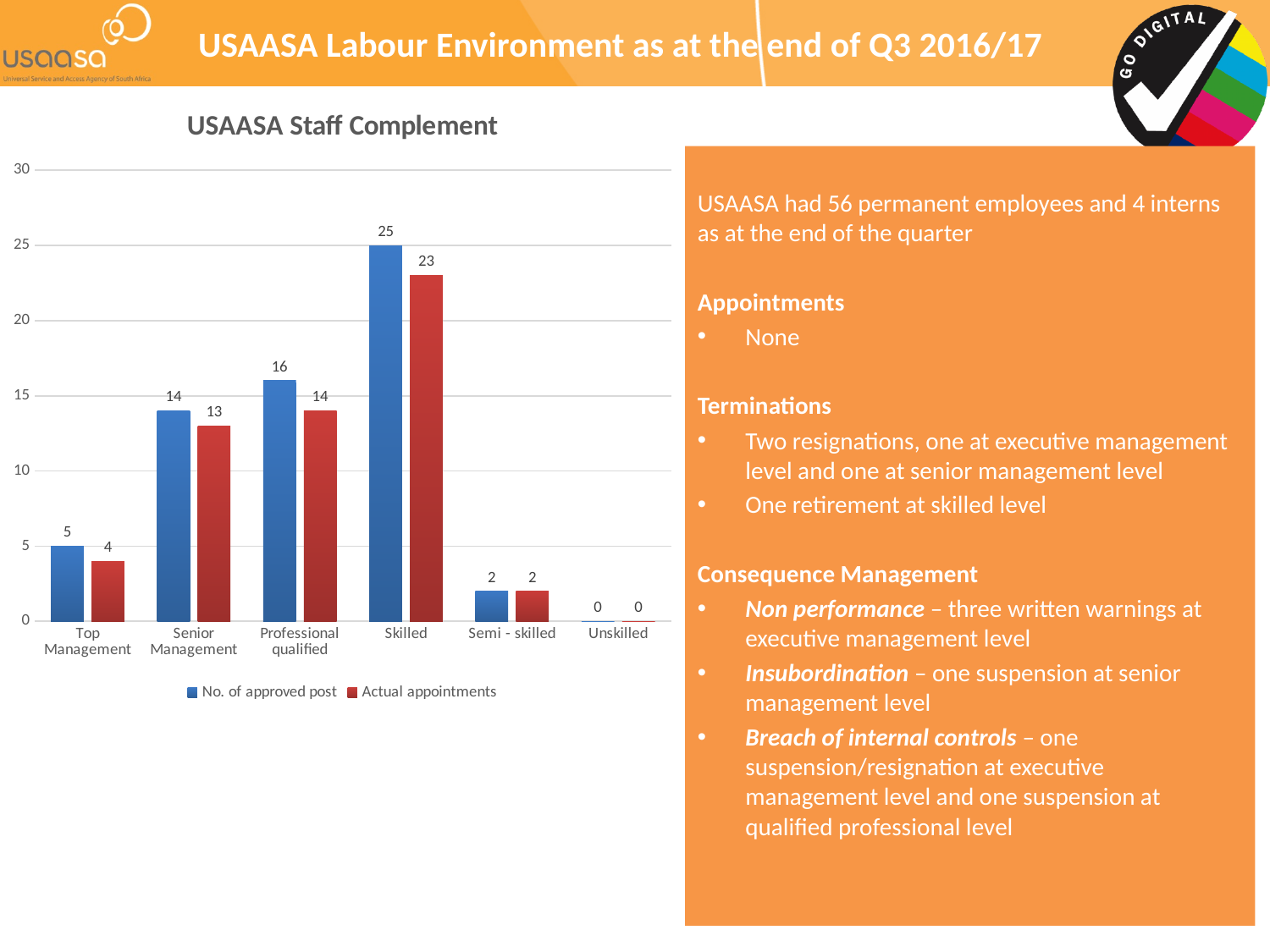
Which category has the highest number of approved posts? Skilled What is the difference between approved posts for Professional qualified and Senior Management? 2 How many series does the legend list? 2 Which category has the lowest value for Actual appointments? Unskilled What is the difference between the number of approved posts and actual appointments for Skilled? 2 What is the number of approved posts for Skilled? 25 What type of chart is shown? bar chart Which is larger for Top Management: the number of approved posts or actual appointments? No. of approved post How many categories are shown on the x axis? 6 What is the value of Actual appointments for Senior Management? 13 What is the number of approved posts for Professional qualified? 16 Is the number of approved posts for Skilled greater or less than 20? greater